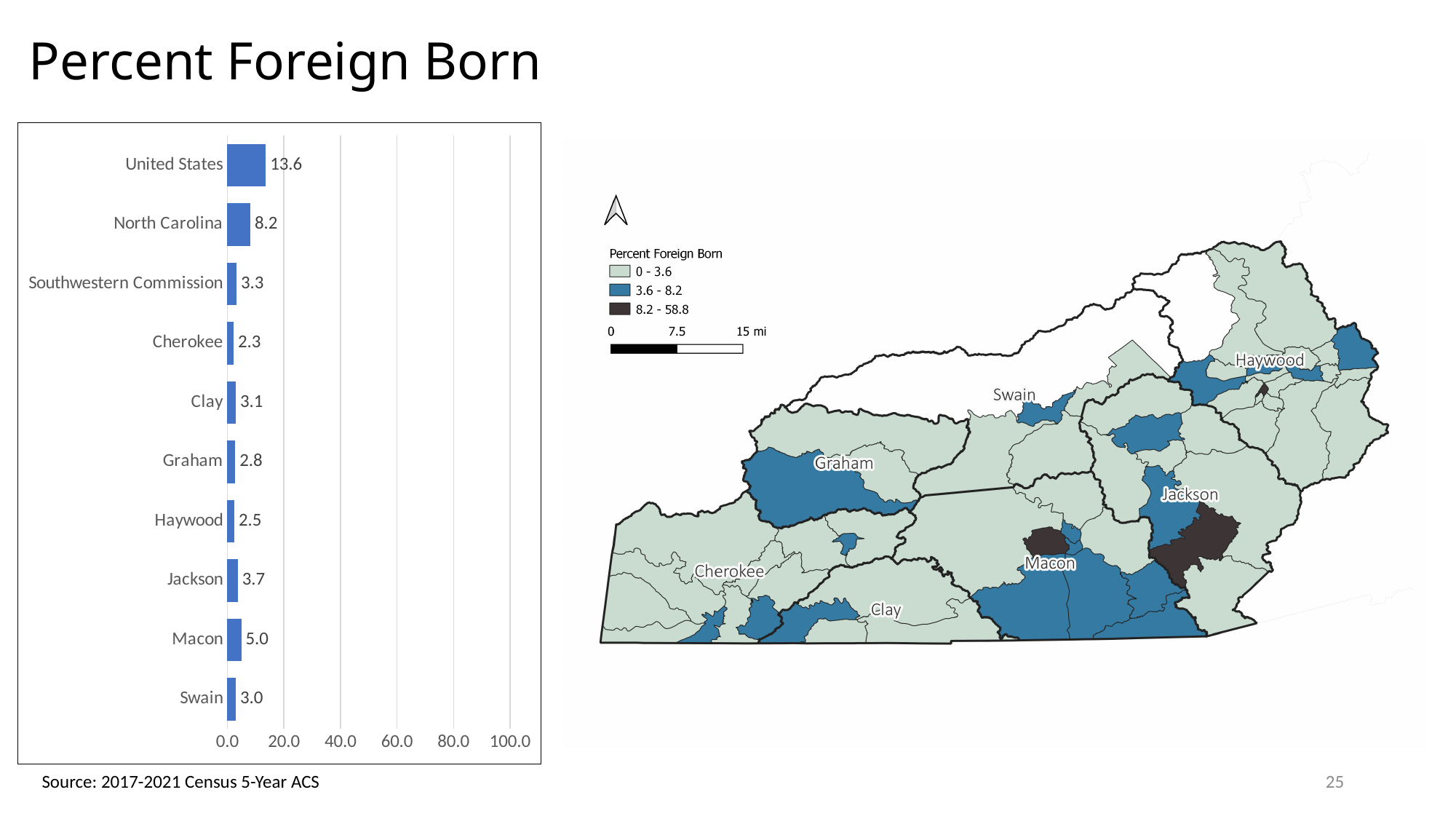
Is the value for United States in the bar chart greater or less than 20.0? less In the bar chart, which is larger, the value for Macon or the value for Graham? Macon What is the difference between the values for Macon and Jackson in the bar chart? 1.3 How many categories are shown in the bar chart? 10 What is the value for Macon in the bar chart? 5.0 What is the value for Haywood in the bar chart? 2.5 What kind of chart is shown on the left of the slide? bar chart What is the value for United States in the bar chart? 13.6 What is the value for Southwestern Commission in the bar chart? 3.3 Which category has the lowest value in the bar chart? Cherokee Which category has the highest value in the bar chart? United States What is the difference between the values for United States and North Carolina in the bar chart? 5.4